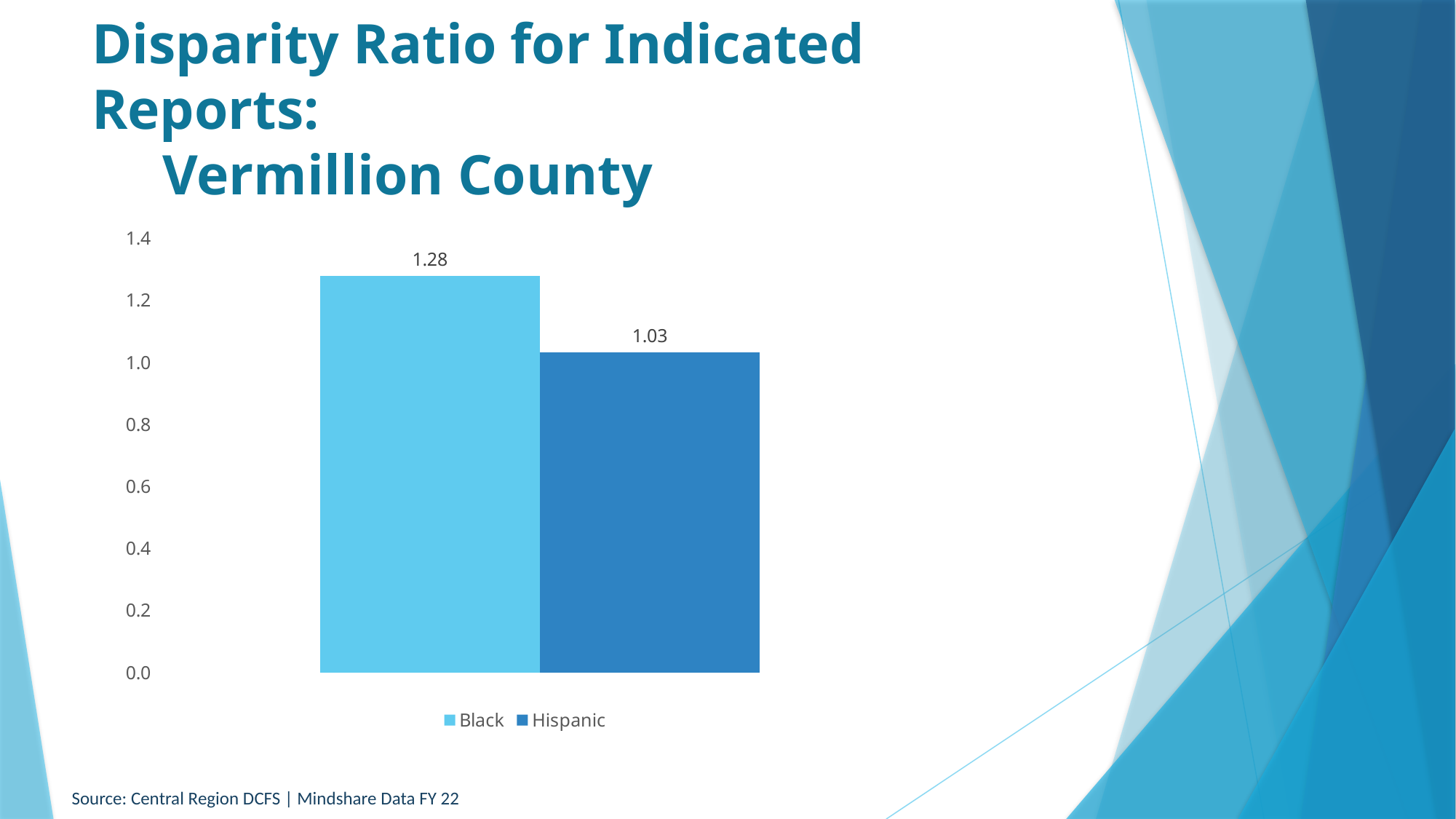
What is the difference between the disparity ratios for Black and Hispanic? 0.25 Is the disparity ratio for Black greater or less than 1.2? greater Which county does the chart's title refer to? Vermillion County What is the disparity ratio for Black in the chart? 1.28 Which group has the higher disparity ratio? Black What is the maximum value shown on the vertical axis? 1.4 Which group has the lower disparity ratio? Hispanic Is the disparity ratio for Hispanic greater or less than 1.0? greater What kind of chart is shown on the slide? bar chart What is the disparity ratio for Hispanic in the chart? 1.03 How many series does the legend list? 2